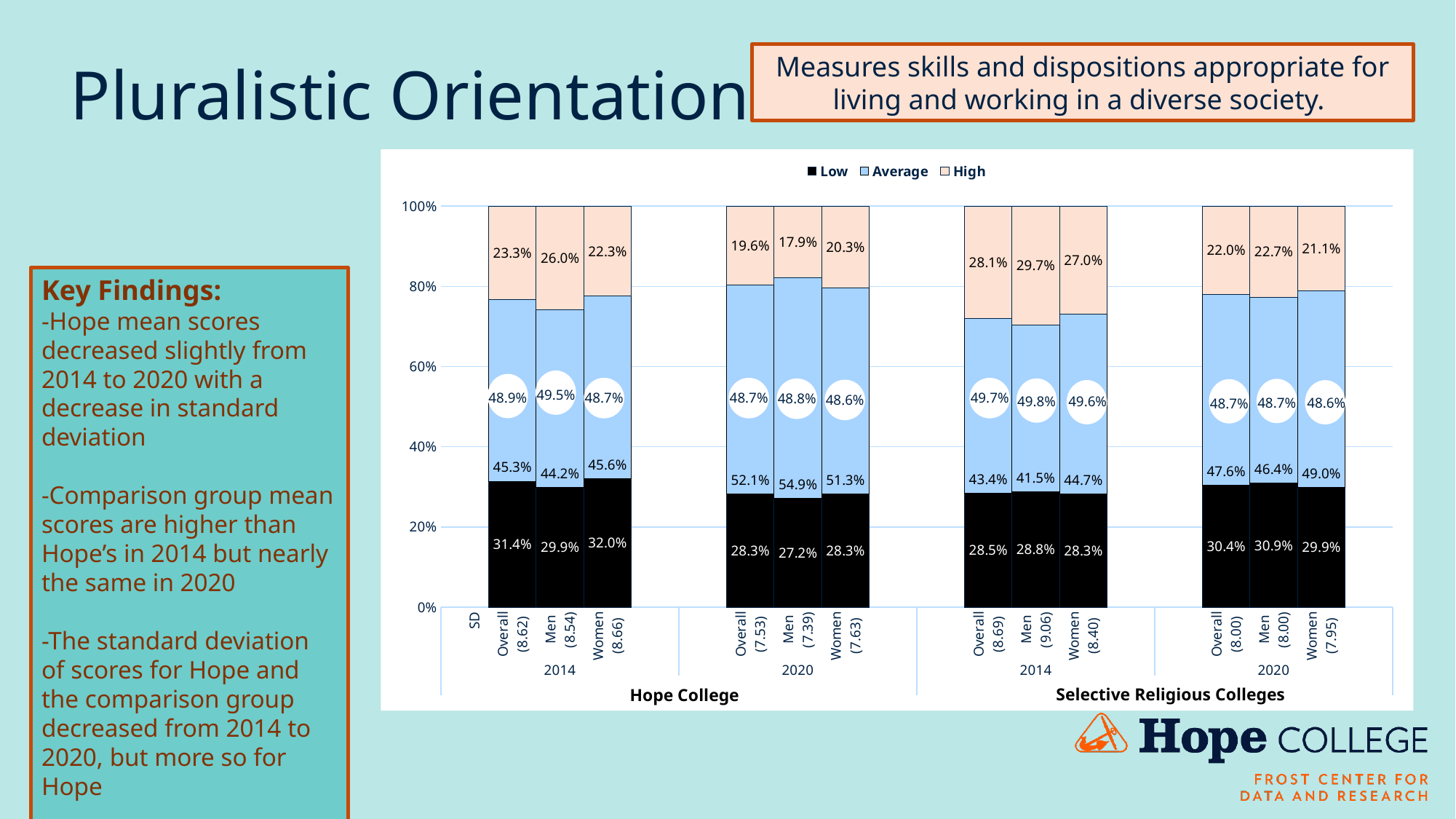
What is the difference between the Average percentage for Hope College Men in 2020 and Hope College Men in 2014? 10.7% What is the Average percentage for Selective Religious Colleges Women in 2020? 49.0% What is the mean score shown in the white circle for Selective Religious Colleges Overall in 2014? 49.7% Which is larger: the High percentage for Hope College Women in 2014 or for Selective Religious Colleges Women in 2014? Selective Religious Colleges Women 2014 (27.0%) Which bar has the lowest Low percentage? Hope College Men 2020 (27.2%) Which bar has the highest High percentage? Selective Religious Colleges Men 2014 (29.7%) What is the standard deviation shown for Hope College Overall in 2020? 7.53 How many series does the legend list? 3 How many bars are plotted in the chart? 12 What is the High percentage for Hope College Men in 2020? 17.9% What is the Low percentage for Hope College Overall in 2014? 31.4% What kind of chart is shown on the slide? Stacked bar chart